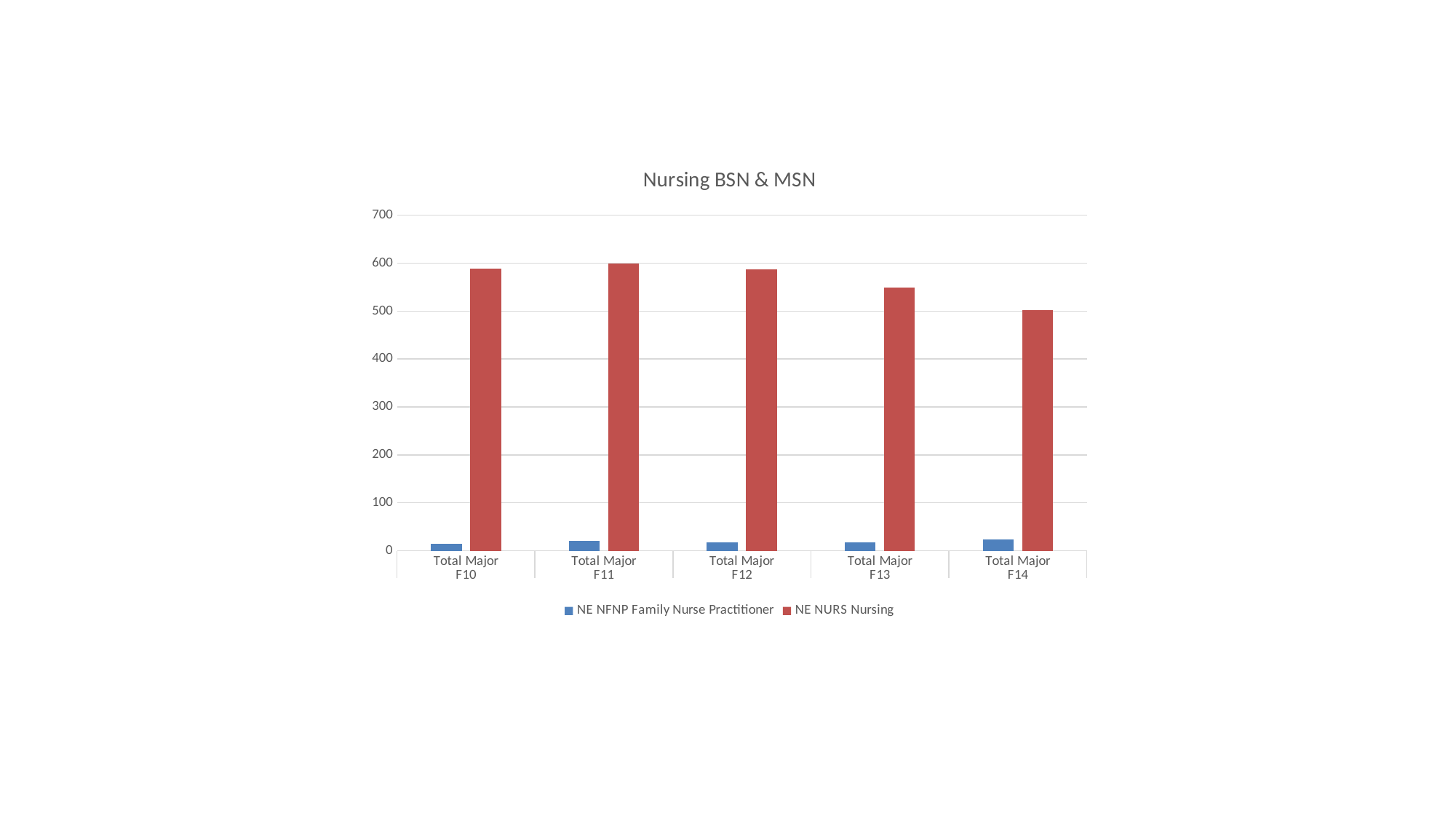
What is the title of the chart? Nursing BSN & MSN How many series does the legend list? 2 Which is larger at Total Major F14: NE NFNP Family Nurse Practitioner or NE NURS Nursing? NE NURS Nursing Do the NE NURS Nursing values rise or fall from Total Major F11 to Total Major F14? fall Which category has the highest value for NE NURS Nursing? Total Major F11 What type of chart is shown on the slide? bar chart How many categories are shown along the x axis? 5 Is the value for NE NURS Nursing at Total Major F13 greater or less than 500? greater Which category has the lowest value for NE NURS Nursing? Total Major F14 Is the value for NE NFNP Family Nurse Practitioner at Total Major F12 greater or less than 100? less Is the value for NE NURS Nursing at Total Major F10 greater or less than 500? greater